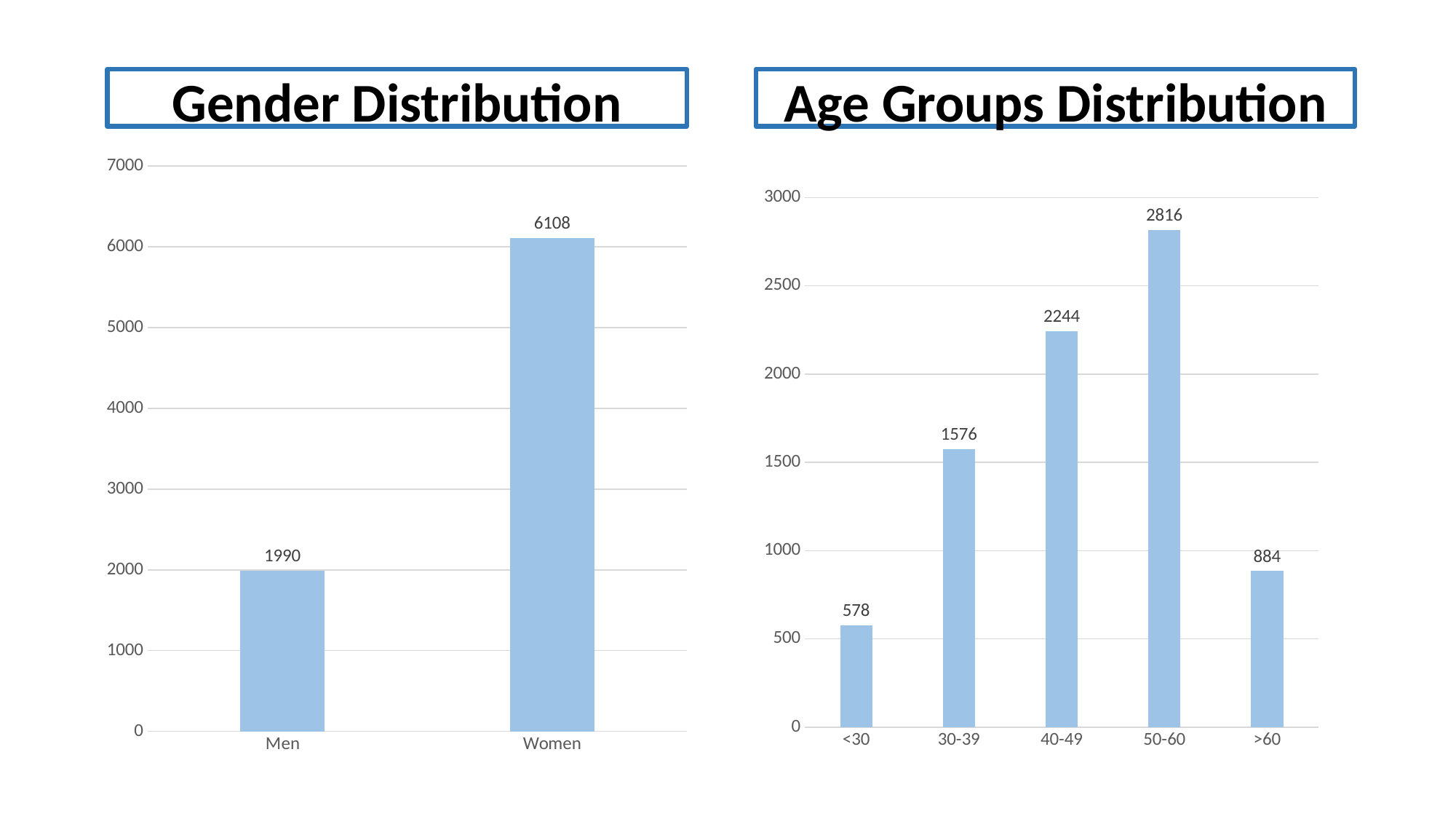
In the Gender Distribution chart, how many categories are shown? 2 What kind of chart is the Age Groups Distribution chart? Bar chart In the Age Groups Distribution chart, which age group has the highest value? 50-60 In the Age Groups Distribution chart, what is the difference between the values for 50-60 and >60? 1932 In the Age Groups Distribution chart, what is the value for the 40-49 group? 2244 In the Gender Distribution chart, what is the difference between the values for Women and Men? 4118 In the Age Groups Distribution chart, how many age groups are shown? 5 What is the title of the chart on the left side of the slide? Gender Distribution In the Age Groups Distribution chart, which is larger, the value for 30-39 or the value for >60? 30-39 In the Age Groups Distribution chart, which age group has the lowest value? <30 In the Gender Distribution chart, what is the value for Men? 1990 In the Gender Distribution chart, what is the value for Women? 6108